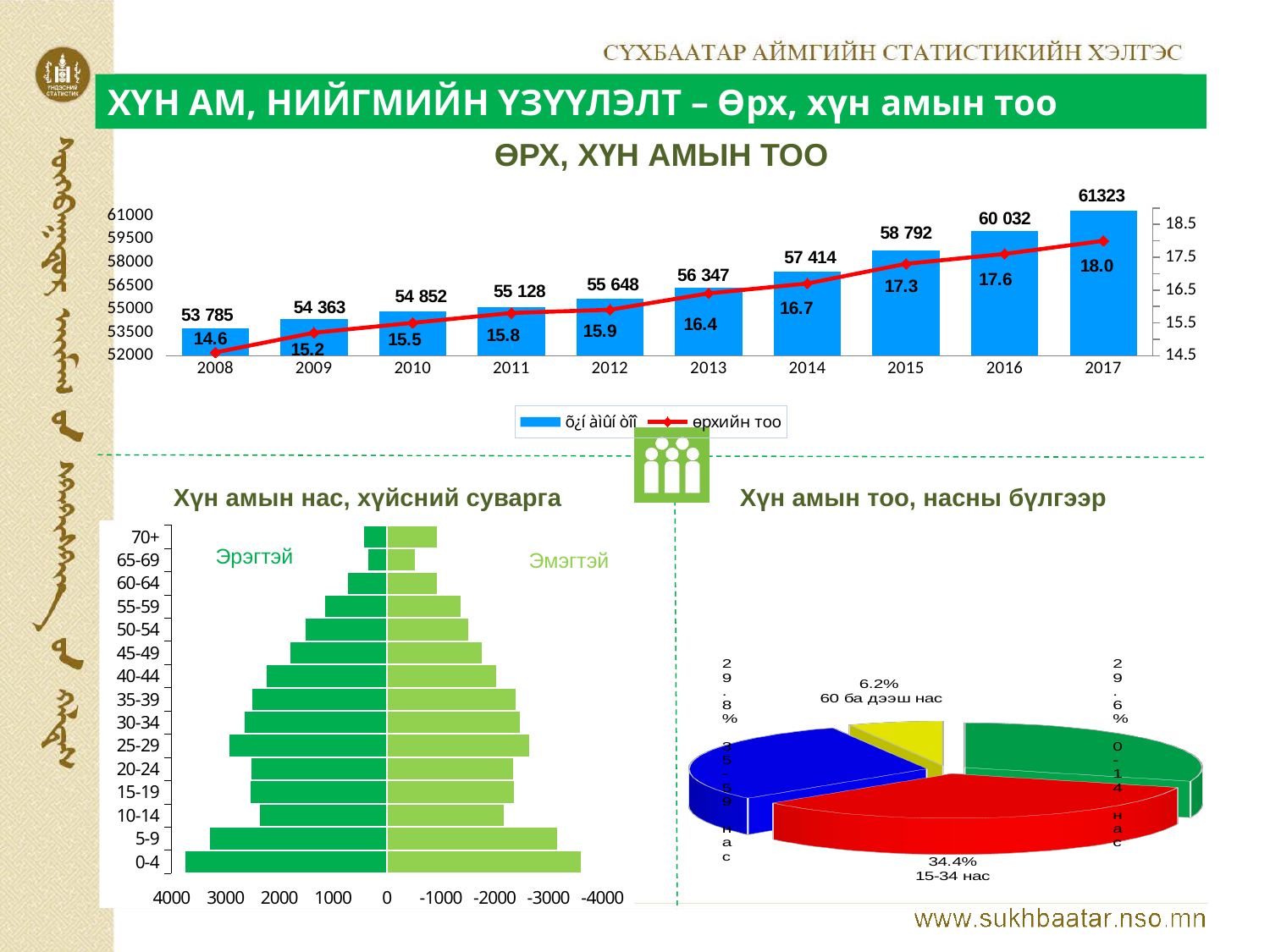
In the chart titled ӨРХ, ХҮН АМЫН ТОО, which year has the highest population bar? 2017 In the chart titled ӨРХ, ХҮН АМЫН ТОО, do the population bars rise or fall from 2008 to 2017? rise In the chart titled Хүн амын тоо, насны бүлгээр, what share does the 15-34 нас slice have? 34.4% In the chart titled ӨРХ, ХҮН АМЫН ТОО, how many series does the legend list? 2 In the chart titled ӨРХ, ХҮН АМЫН ТОО, what is the population value shown for 2008? 53 785 In the chart titled ӨРХ, ХҮН АМЫН ТОО, how many years are shown on the x axis? 10 In the chart titled ӨРХ, ХҮН АМЫН ТОО, what is the population value shown for 2017? 61323 In the chart titled Хүн амын нас, хүйсний суварга, how many age groups are listed on the vertical axis? 15 In the chart titled ӨРХ, ХҮН АМЫН ТОО, which year has the lowest өрхийн тоо value? 2008 In the chart titled ӨРХ, ХҮН АМЫН ТОО, what value does the өрхийн тоо line show for 2015? 17.3 In the chart titled ӨРХ, ХҮН АМЫН ТОО, what is the difference between the population values for 2016 and 2015? 1 240 In the chart titled Хүн амын тоо, насны бүлгээр, which age group has the smallest slice? 60 ба дээш нас